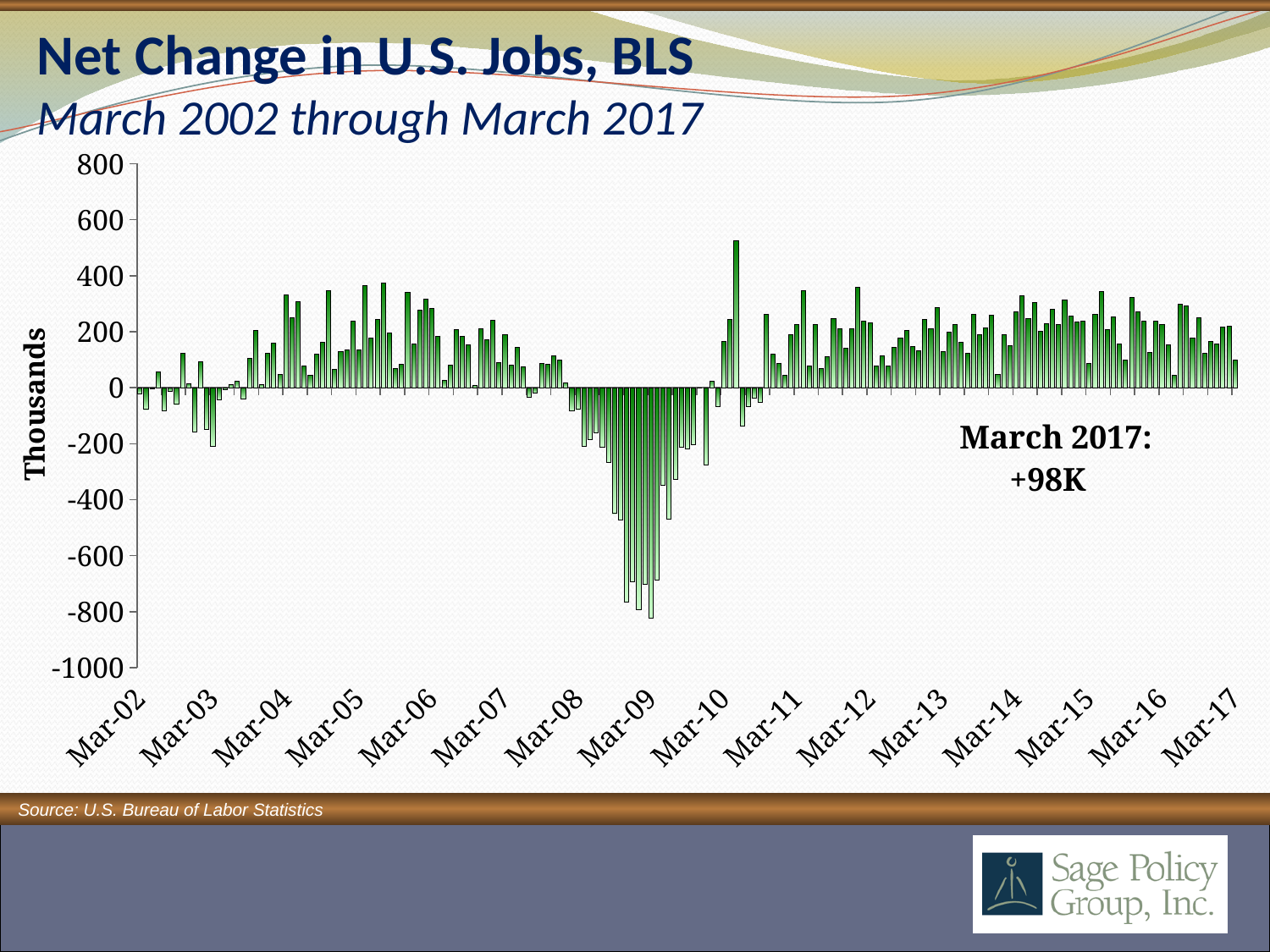
Is the tallest bar on the chart, shortly after Mar-10, greater or less than 400? greater What is the net change in U.S. jobs for March 2017 as printed on the slide? +98K Do the values generally rise or fall between Mar-09 and Mar-10? rise What is the title of the chart? Net Change in U.S. Jobs, BLS Is the lowest bar on the chart, near Mar-09, greater or less than -600? less Is the value for March 2017 greater or less than 200? less How many year labels (Mar-02 through Mar-17) are shown on the x axis? 16 What kind of chart is shown on the slide? bar chart Do the values generally rise or fall between Mar-08 and Mar-09? fall Around which x-axis label do the most negative bars occur? Mar-09 Which is larger: the value for March 2017 or the lowest bar near Mar-09? March 2017 What label is shown on the vertical axis? Thousands